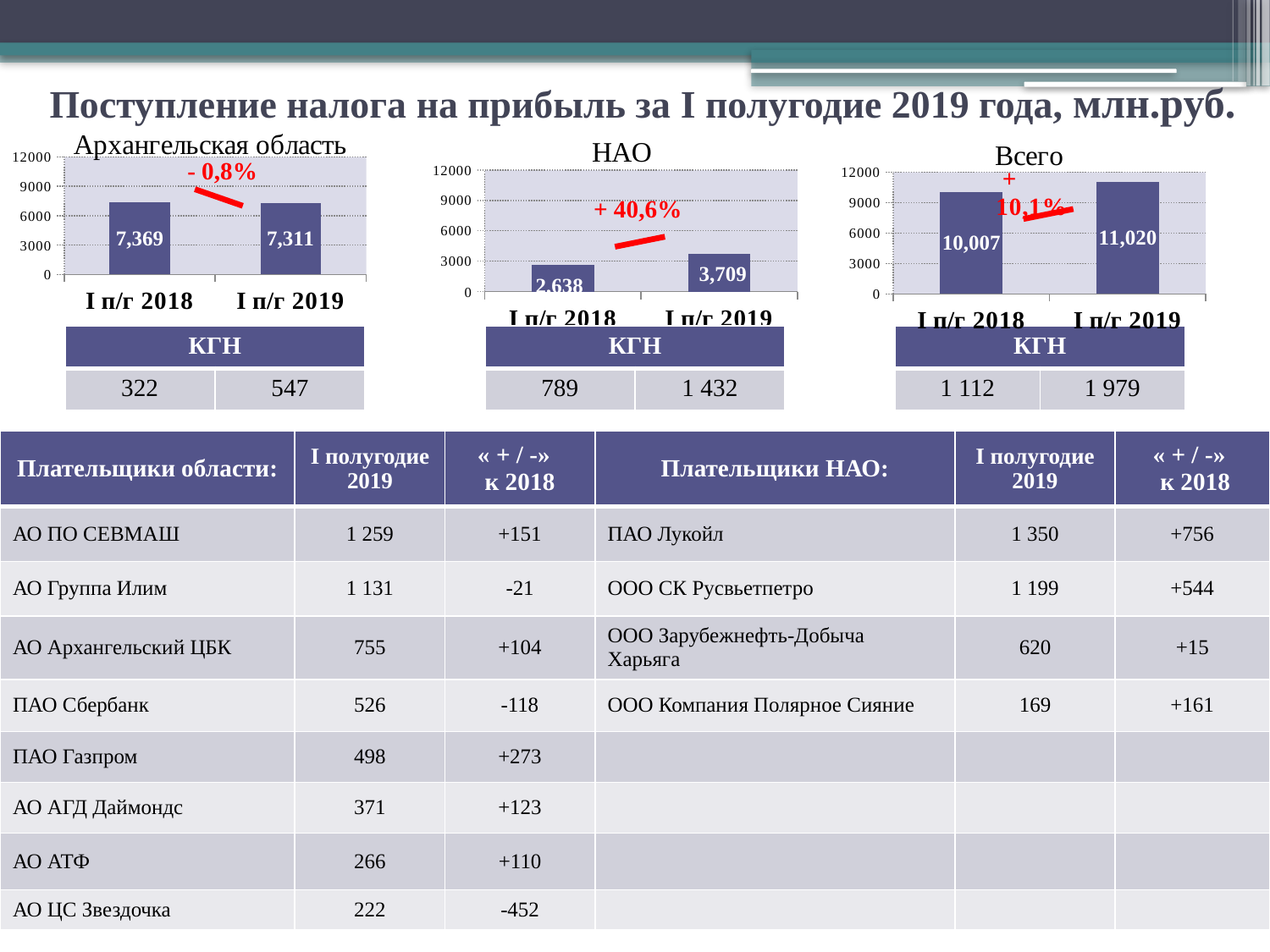
In the chart titled "НАО", what is the difference between the I п/г 2019 and I п/г 2018 values? 1,071 In the chart titled "Архангельская область", what is the difference between the I п/г 2018 and I п/г 2019 values? 58 In the chart titled "Всего", which of the two periods has the lower value? I п/г 2018 In the chart titled "НАО", what is the value for I п/г 2019? 3,709 In the chart titled "НАО", which of the two periods has the higher value? I п/г 2019 In the chart titled "Всего", what is the difference between the I п/г 2019 and I п/г 2018 values? 1,013 In the chart titled "Всего", what is the value for I п/г 2018? 10,007 What kind of chart is the chart titled "Всего"? bar chart In the chart titled "НАО", what percentage change is annotated between the two bars? + 40,6% In the chart titled "НАО", is the value for I п/г 2018 greater or less than 3000? less In the chart titled "Архангельская область", what is the value for I п/г 2018? 7,369 In the chart titled "Архангельская область", what is the value for I п/г 2019? 7,311